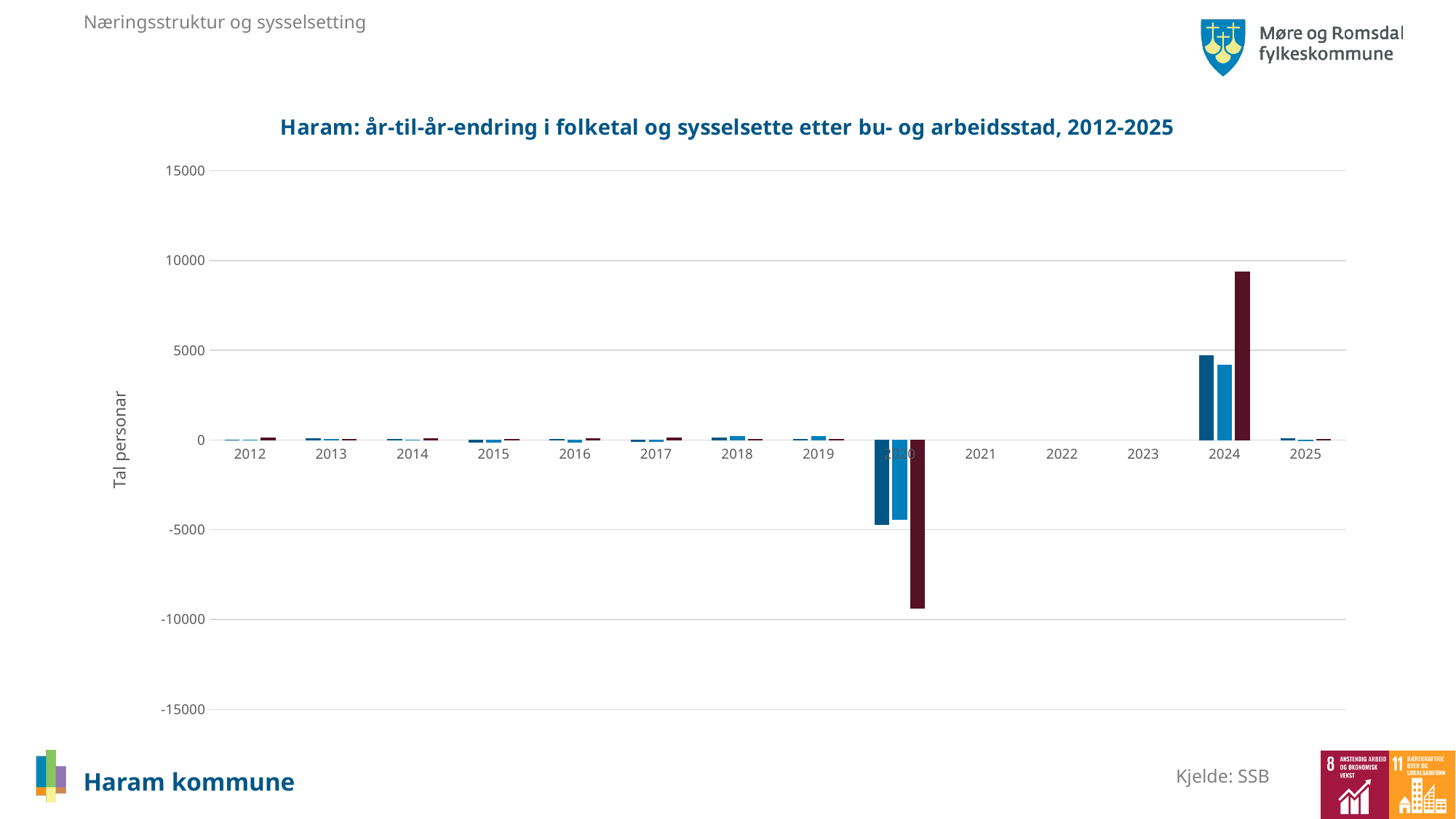
In which year is the dark red bar highest? 2024 Is the value of the light blue bar for 2024 greater or less than 5000? less How many bars are plotted for each year in the chart? 3 What is the title of the chart? Haram: år-til-år-endring i folketal og sysselsette etter bu- og arbeidsstad, 2012-2025 In which year is the dark red bar lowest? 2020 What is the label on the vertical axis of the chart? Tal personar How many years are shown along the x axis of the chart? 14 Is the value of the light blue bar for 2020 greater or less than -5000? greater For 2024, which is larger: the dark red bar or the dark blue bar? the dark red bar Is the value of the dark red bar for 2024 greater or less than 5000? greater What kind of chart is shown on the slide? bar chart